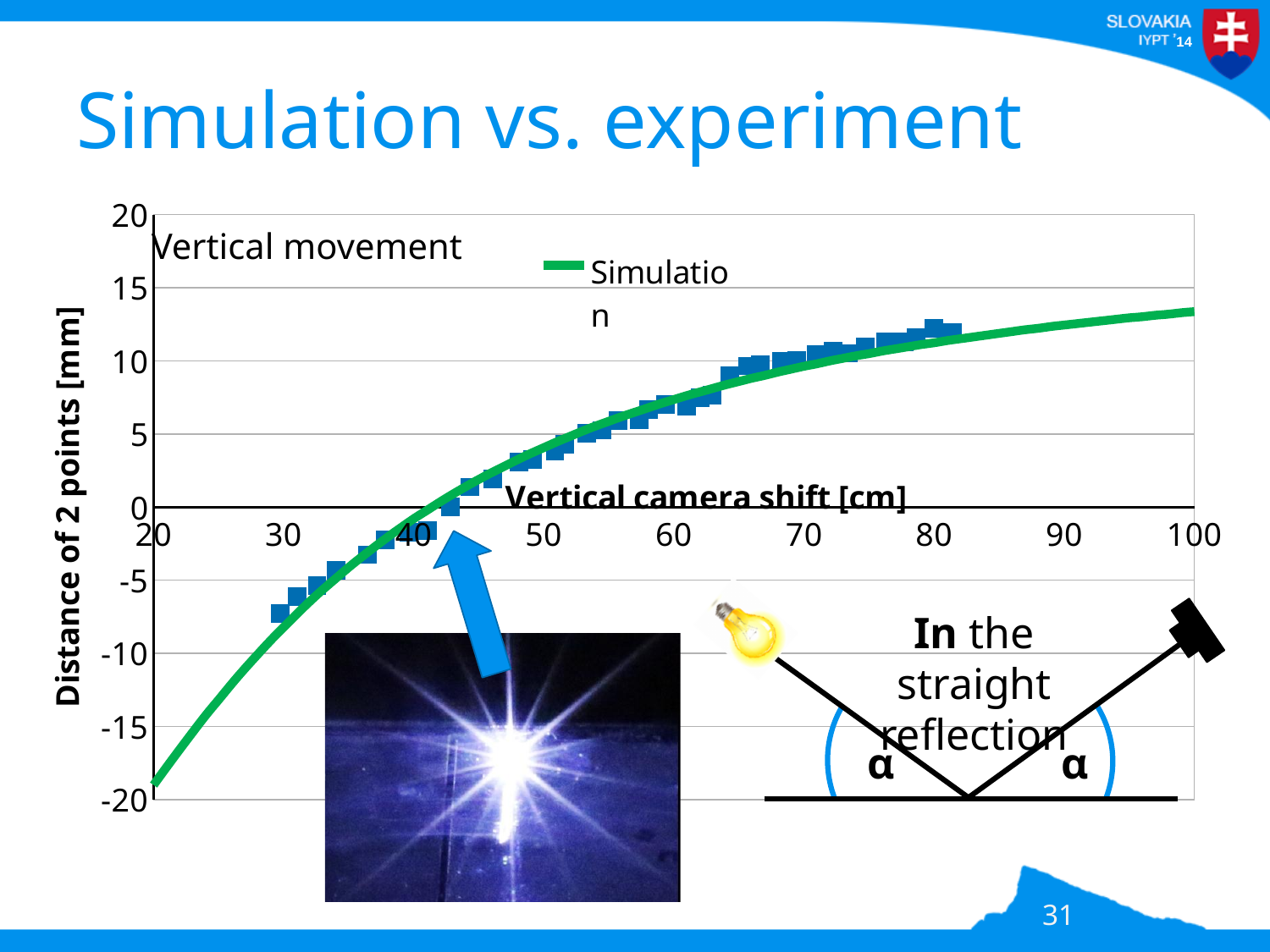
Is the simulation value at a vertical camera shift of 100 cm greater or less than 10? greater What is the label of the y axis of the chart? Distance of 2 points [mm] Which is larger, the simulation value at a vertical camera shift of 90 cm or at 40 cm? 90 cm What is the title of the chart? Vertical movement Is the simulation value at a vertical camera shift of 30 cm greater or less than -5? less How many series does the chart's legend list? 1 Is the simulation value at a vertical camera shift of 60 cm greater or less than 5? greater Does the simulation curve rise or fall as the vertical camera shift increases from 20 to 100 cm? rise What kind of chart is shown on the slide? line chart